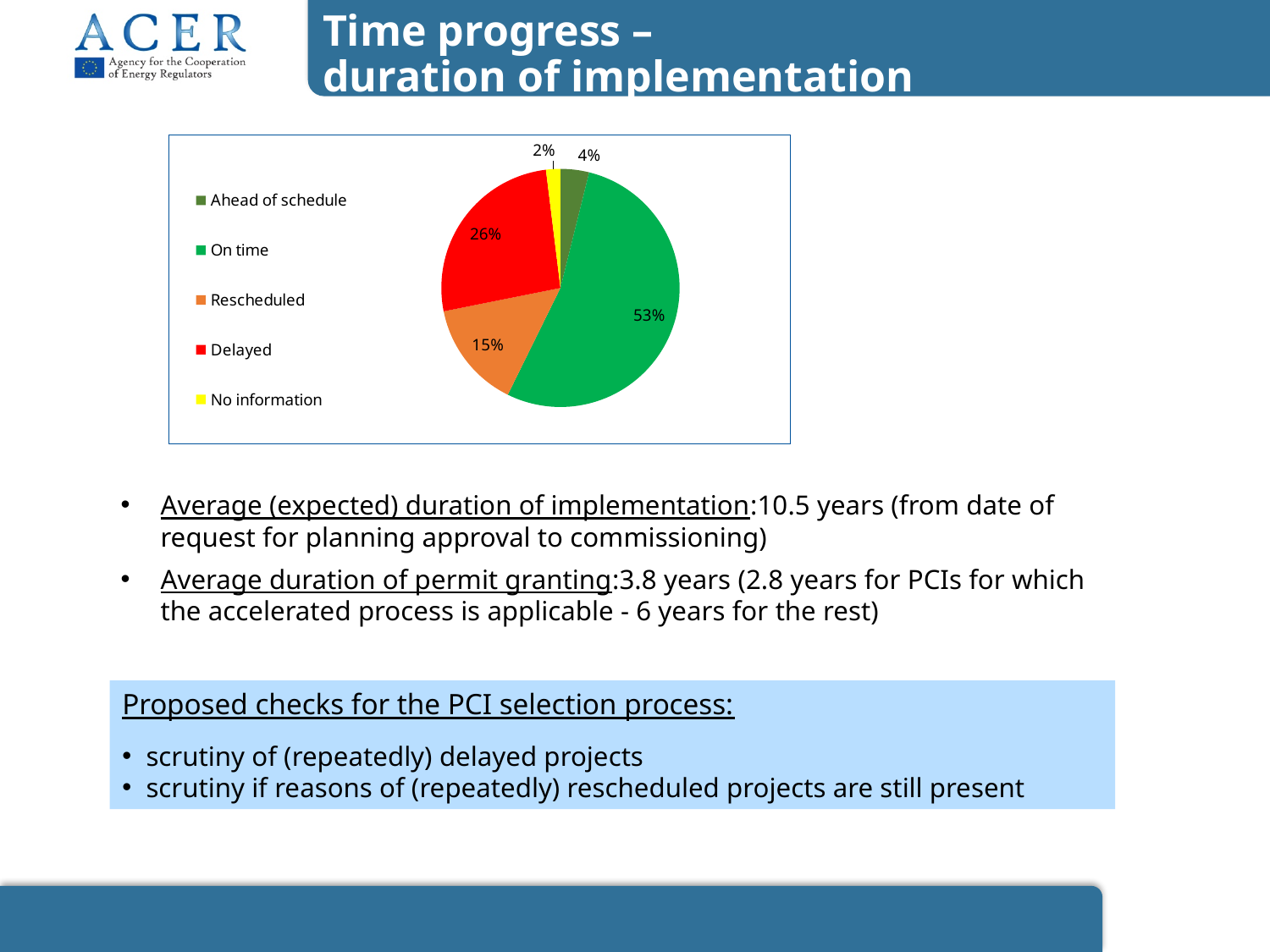
Which slice is larger, "Delayed" or "Rescheduled"? Delayed What is the difference in percentage points between the "Delayed" and "Rescheduled" slices? 11 What share of the pie is labelled "Ahead of schedule"? 4% What share of the pie is labelled "Delayed"? 26% What colour is the "Delayed" slice in the pie chart? Red Which category has the largest slice of the pie? On time What share of the pie is labelled "Rescheduled"? 15% How many categories does the legend of the pie chart list? 5 What kind of chart is shown on the slide? Pie chart Which category has the smallest slice of the pie? No information